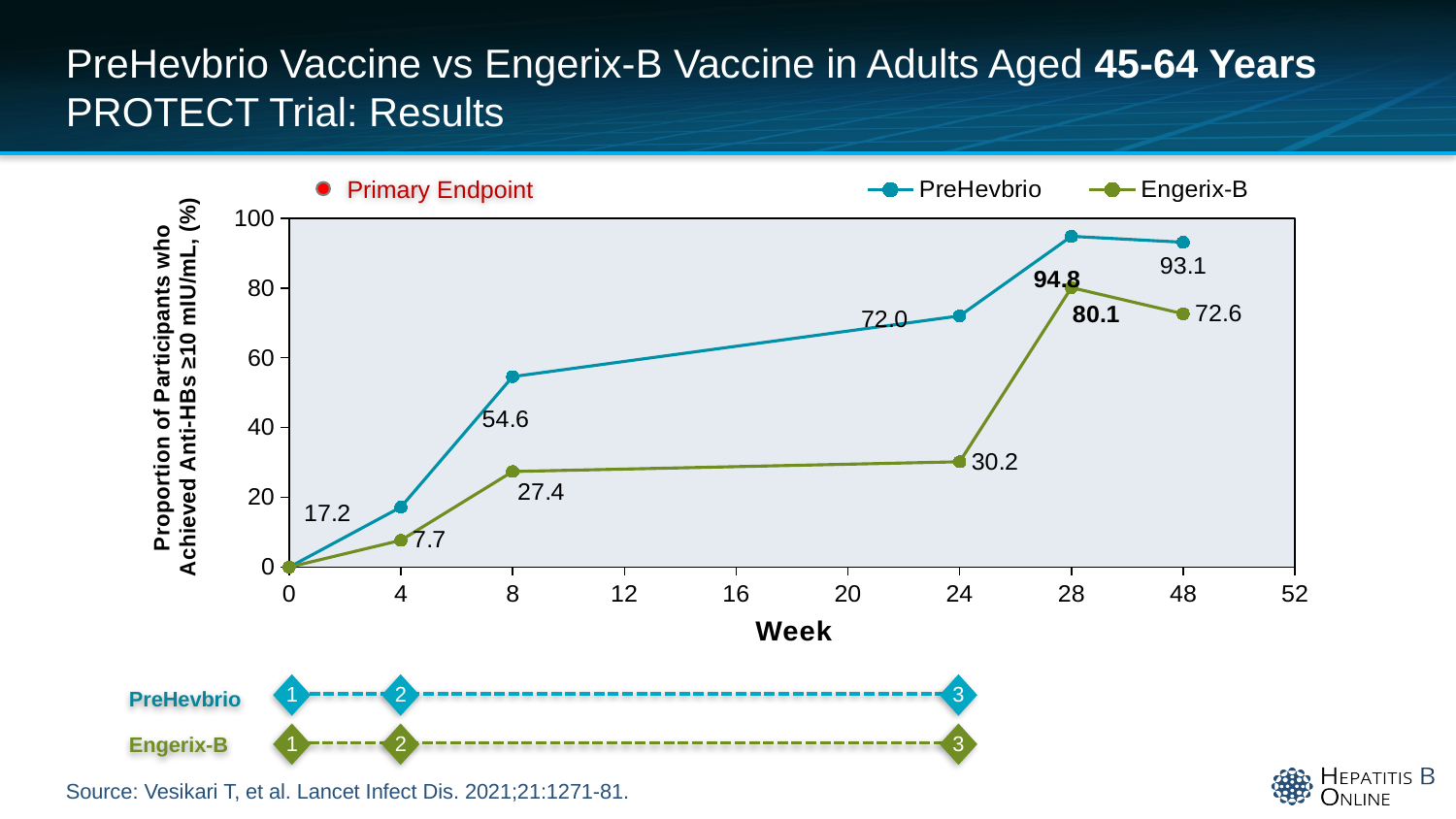
Which series has the higher value at week 24, PreHevbrio or Engerix-B? PreHevbrio What is the value for PreHevbrio at week 8? 54.6 What is the difference between PreHevbrio and Engerix-B at week 28? 14.7 What is the value for PreHevbrio at week 28? 94.8 Does the Engerix-B series rise or fall between week 28 and week 48? fall What is the difference between PreHevbrio and Engerix-B at week 4? 9.5 What is the value for Engerix-B at week 48? 72.6 What type of chart is shown on the slide? line chart At which week does the PreHevbrio series reach its highest labelled value? 28 What is the value for Engerix-B at week 24? 30.2 How many series does the chart legend list? 2 What is the label of the x axis? Week